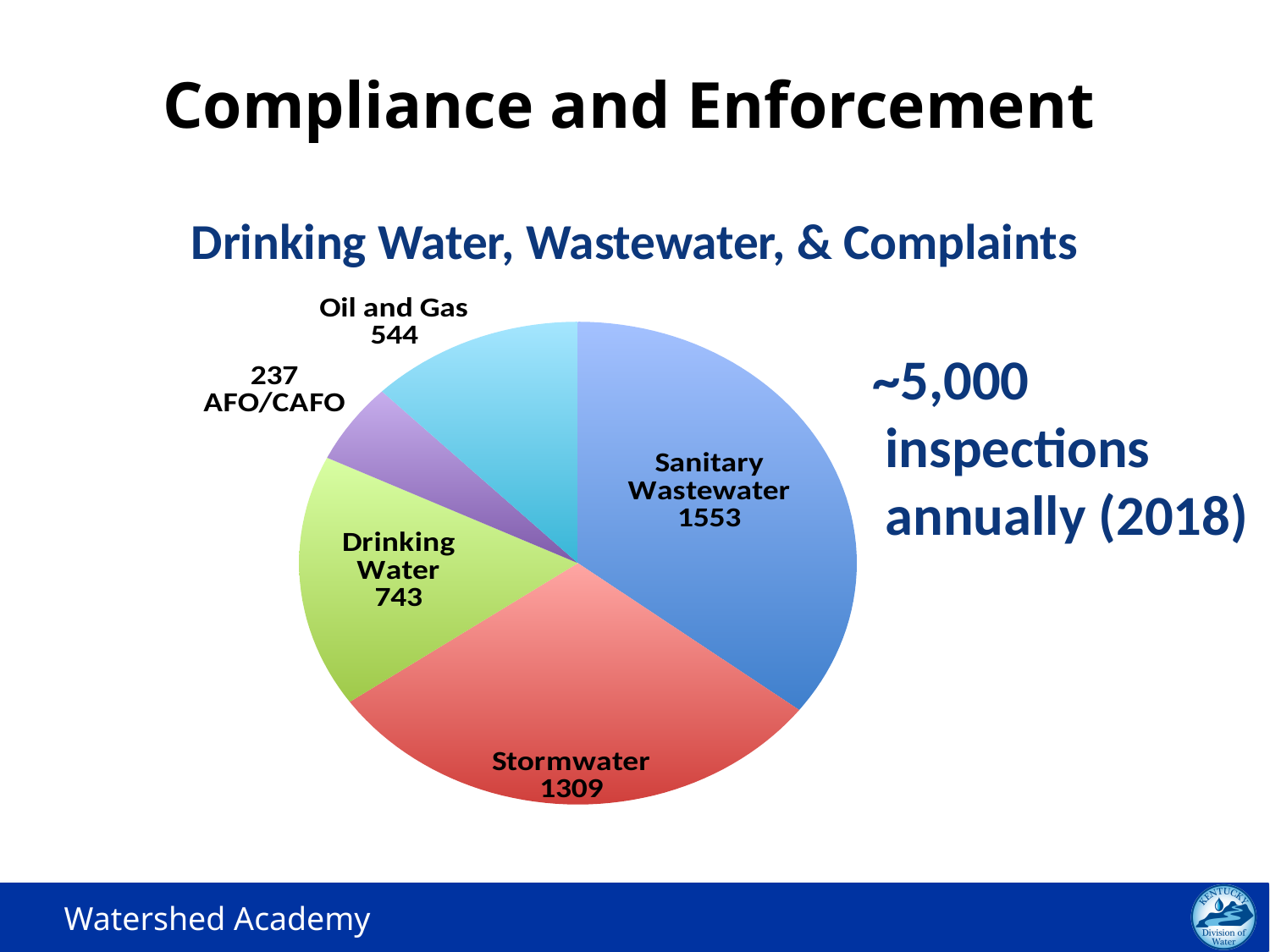
What is the difference between the Sanitary Wastewater and Stormwater values? 244 Which category has the largest slice of the pie? Sanitary Wastewater Which is larger, Drinking Water or Oil and Gas? Drinking Water What kind of chart is shown on the slide? pie chart What is the value for AFO/CAFO? 237 What is the value for Oil and Gas? 544 What is the value for Drinking Water? 743 Which category has the smallest slice of the pie? AFO/CAFO What is the title of the chart? Drinking Water, Wastewater, & Complaints What is the value for Stormwater? 1309 What is the value for Sanitary Wastewater? 1553 How many categories are shown in the pie chart? 5